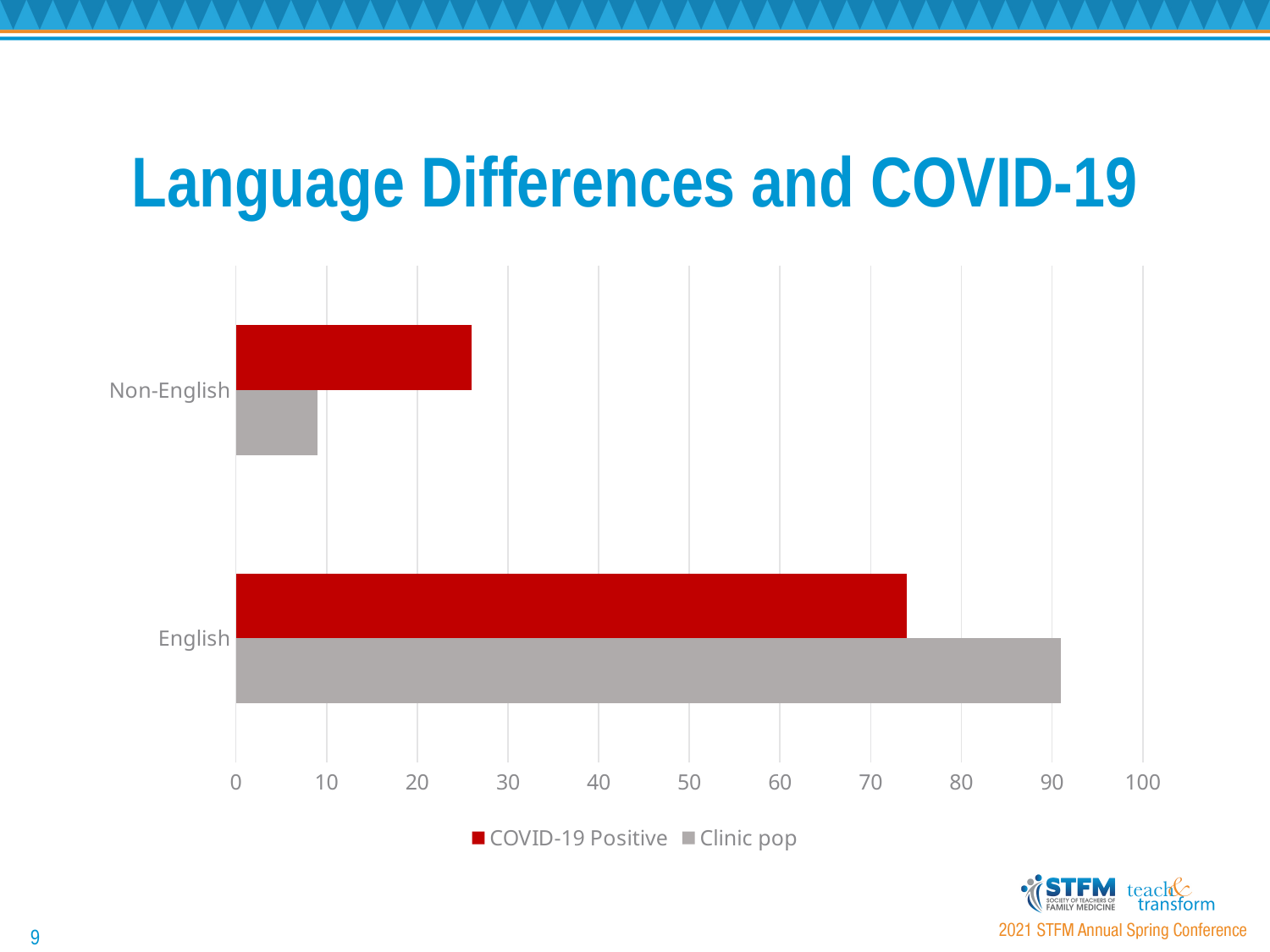
For English, which is larger: COVID-19 Positive or Clinic pop? Clinic pop How many language categories are shown on the chart? 2 How many series does the legend list? 2 Is the COVID-19 Positive value for Non-English greater or less than 20? greater Which category has the highest COVID-19 Positive value? English What kind of chart is shown on the slide? bar chart What colour are the COVID-19 Positive bars? red Is the Clinic pop value for English greater or less than 90? greater Is the COVID-19 Positive value for English greater or less than 70? greater Which category has the lowest Clinic pop value? Non-English For Non-English, which is larger: COVID-19 Positive or Clinic pop? COVID-19 Positive